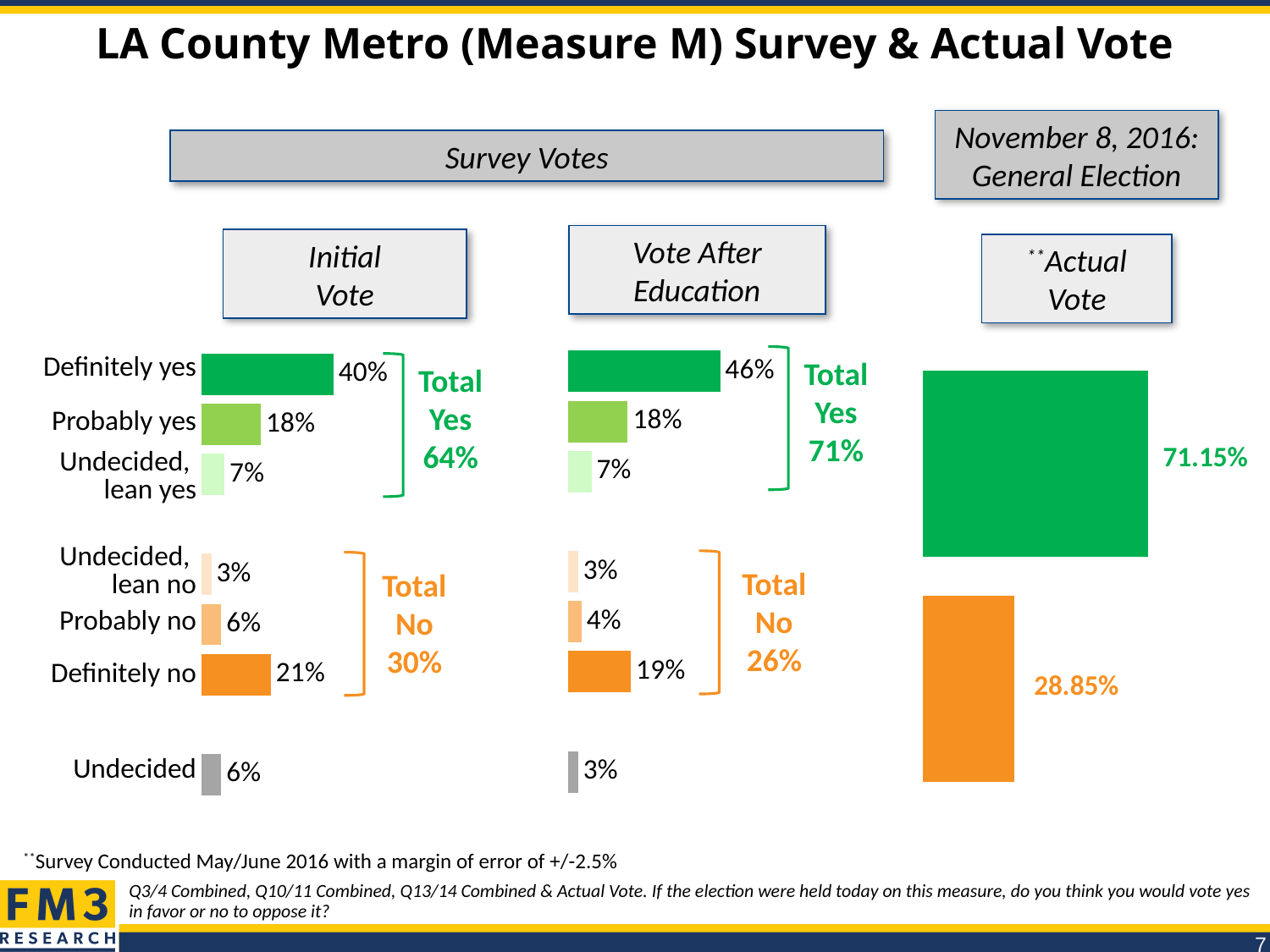
What type of chart is used to show the Actual Vote? Bar chart How many categories are plotted in the Initial Vote chart? 7 What is the Total No shown for the Initial Vote chart? 30% In the Actual Vote chart, what percentage is shown for the yes vote (green bar)? 71.15% What is the Total Yes shown for the Vote After Education chart? 71% In the Vote After Education chart, which category has the lowest percentage? Undecided, lean no, Undecided (both 3%) Which is larger: Probably no in the Initial Vote chart or Probably no in the Vote After Education chart? Initial Vote (6%) What is the difference between the Definitely no percentage in the Initial Vote chart and in the Vote After Education chart? 2% In the Initial Vote chart, what percentage is shown for Definitely yes? 40% In the Vote After Education chart, what percentage is shown for Definitely yes? 46% In the Initial Vote chart, which category has the highest percentage? Definitely yes In the Actual Vote chart, what percentage is shown for the no vote (orange bar)? 28.85%